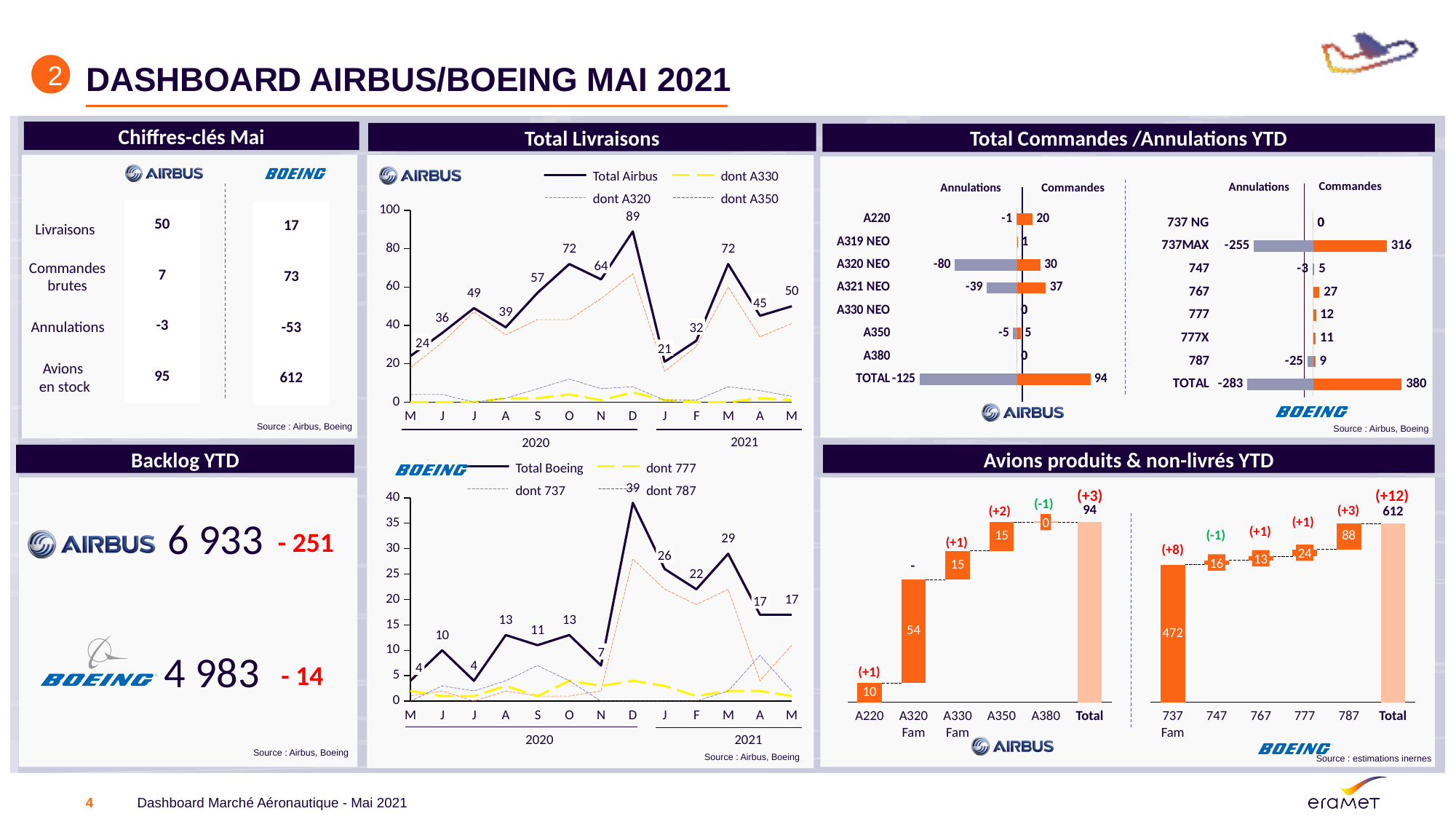
In the Airbus 'Total Livraisons' line chart, which month has the highest Total Airbus value? December 2020 In the 'Avions produits & non-livrés YTD' chart, what is the Airbus Total value? 94 How many series does the legend of the Airbus 'Total Livraisons' chart list? 4 In the Boeing 'Total Livraisons' line chart, which is larger: the Total Boeing value for March 2021 or for February 2021? March 2021 In the Airbus 'Total Livraisons' line chart, what is the Total Airbus value for December 2020? 89 In the Boeing 'Total Livraisons' line chart, what is the Total Boeing value for December 2020? 39 In the 'Total Commandes /Annulations YTD' Boeing chart, what is the Commandes value for 737MAX? 316 In the 'Avions produits & non-livrés YTD' chart, what is the value for the Boeing 737 Fam? 472 In the 'Total Commandes /Annulations YTD' Boeing chart, what is the TOTAL Annulations value? -283 In the Airbus 'Total Livraisons' line chart, what is the difference between the Total Airbus values for March 2021 and April 2021? 27 In the Boeing 'Total Livraisons' line chart, what is the Total Boeing value for May 2020? 4 In the 'Total Commandes /Annulations YTD' Airbus chart, what is the Annulations value for A320 NEO? -80